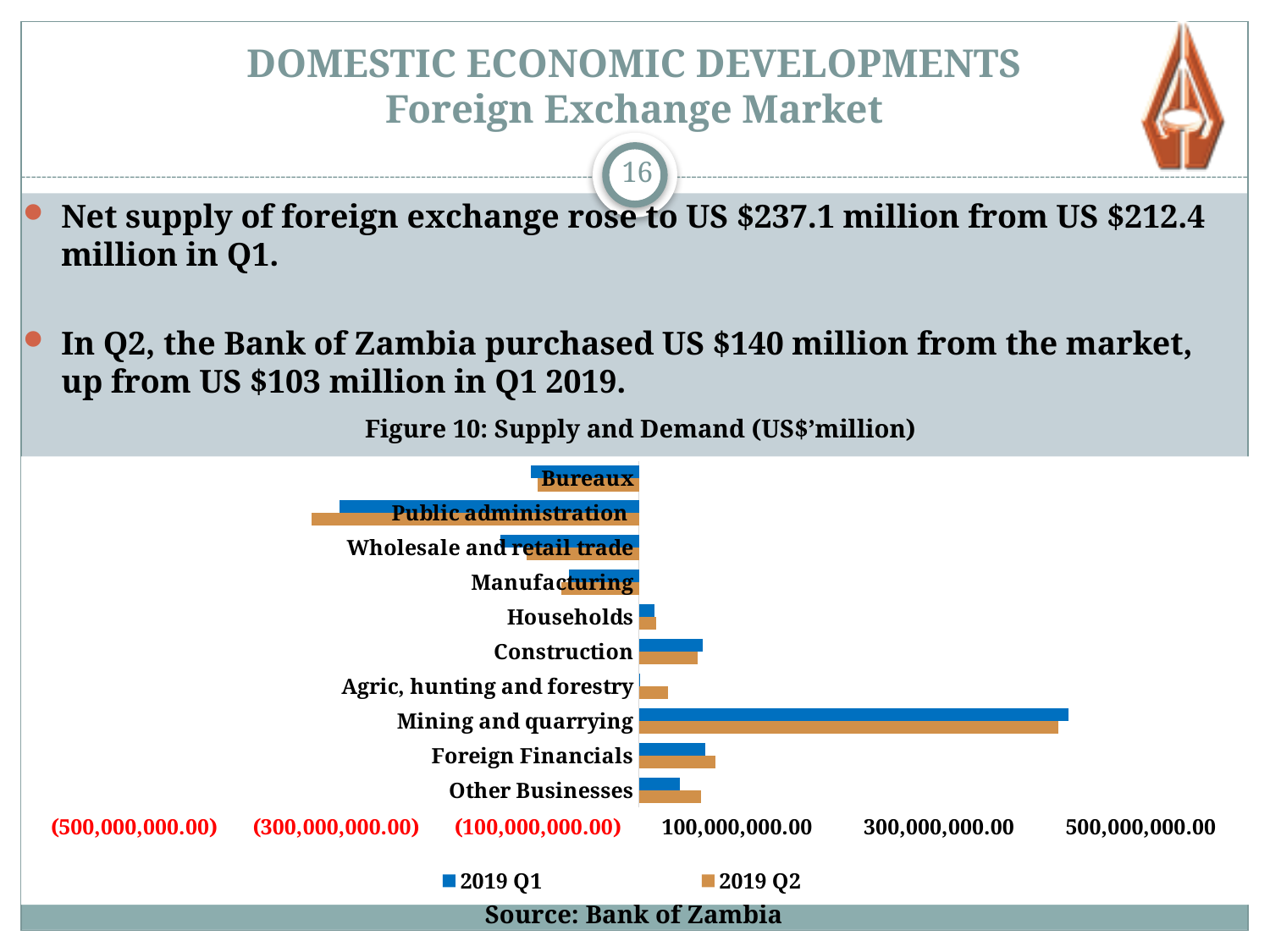
What are the two series named in the legend of the Figure 10 chart? 2019 Q1 and 2019 Q2 What kind of chart is shown in Figure 10? bar chart How many series does the legend of the Figure 10 chart list? 2 Is the 2019 Q1 value for Mining and quarrying greater or less than 300,000,000.00? greater For Agric, hunting and forestry, which series has the larger value, 2019 Q1 or 2019 Q2? 2019 Q2 How many categories are plotted in the Figure 10 chart? 10 For Other Businesses, which series has the larger value, 2019 Q1 or 2019 Q2? 2019 Q2 Which category has the highest value in the Figure 10 chart? Mining and quarrying What is the title of the chart on the slide? Figure 10: Supply and Demand (US$'million) Is the 2019 Q2 value for Public administration greater or less than (100,000,000.00)? less Which category has the lowest (most negative) value in the Figure 10 chart? Public administration Is the 2019 Q1 value for Construction greater or less than 100,000,000.00? less